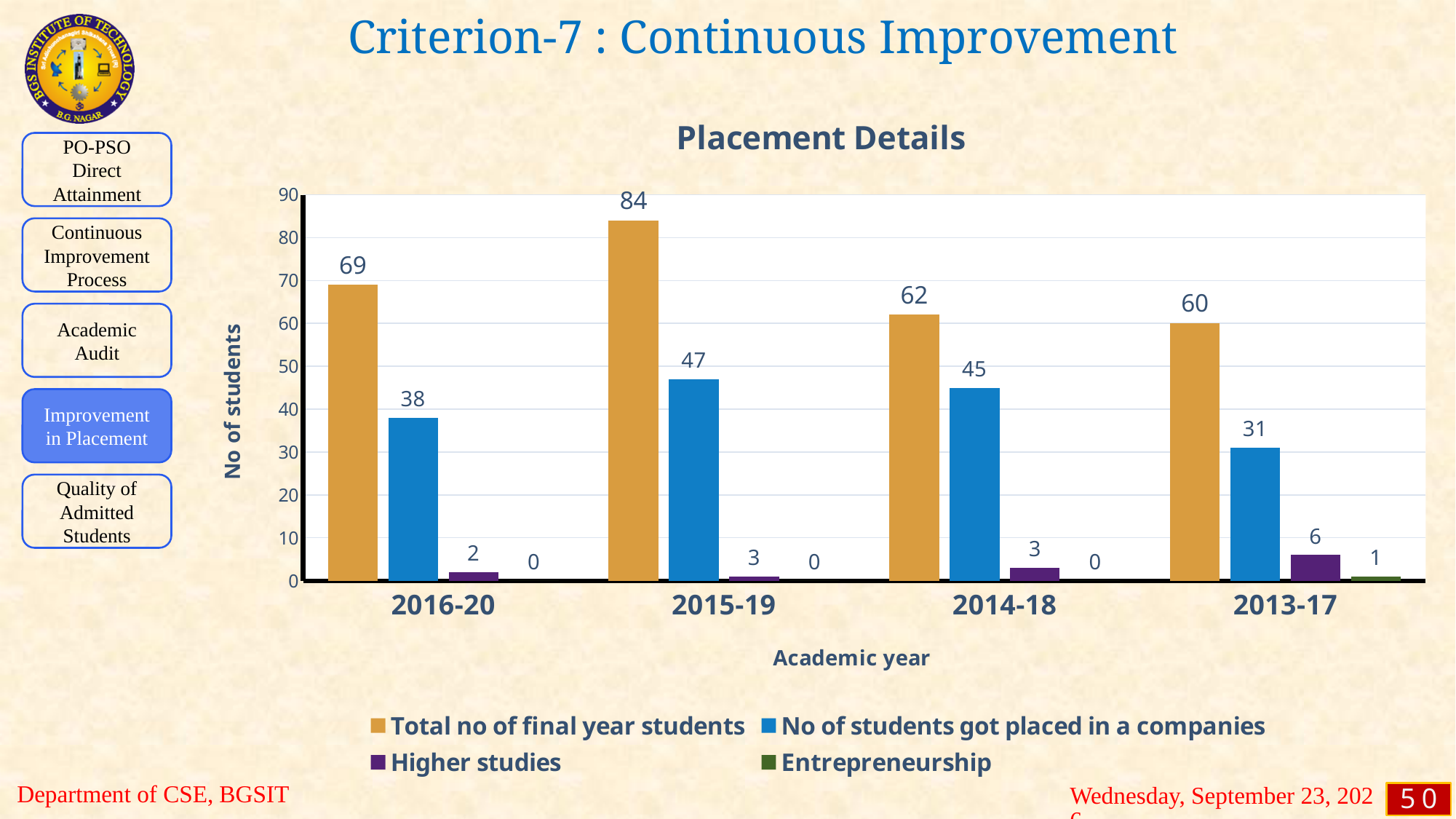
How many students got placed in companies in 2013-17? 31 Which is larger: the number of students placed in 2015-19 or in 2014-18? 2015-19 What is the total number of final year students for 2015-19? 84 What is the difference between the total number of final year students and the number placed in companies in 2016-20? 31 How many series does the legend list? 4 What is the title of the chart? Placement Details What kind of chart is shown on the slide? Bar chart Which academic year has the lowest number of students placed in companies? 2013-17 How many academic years are shown on the x axis? 4 Which academic year has the highest total number of final year students? 2015-19 What is the Higher studies value for 2014-18? 3 What is the Entrepreneurship value for 2013-17? 1